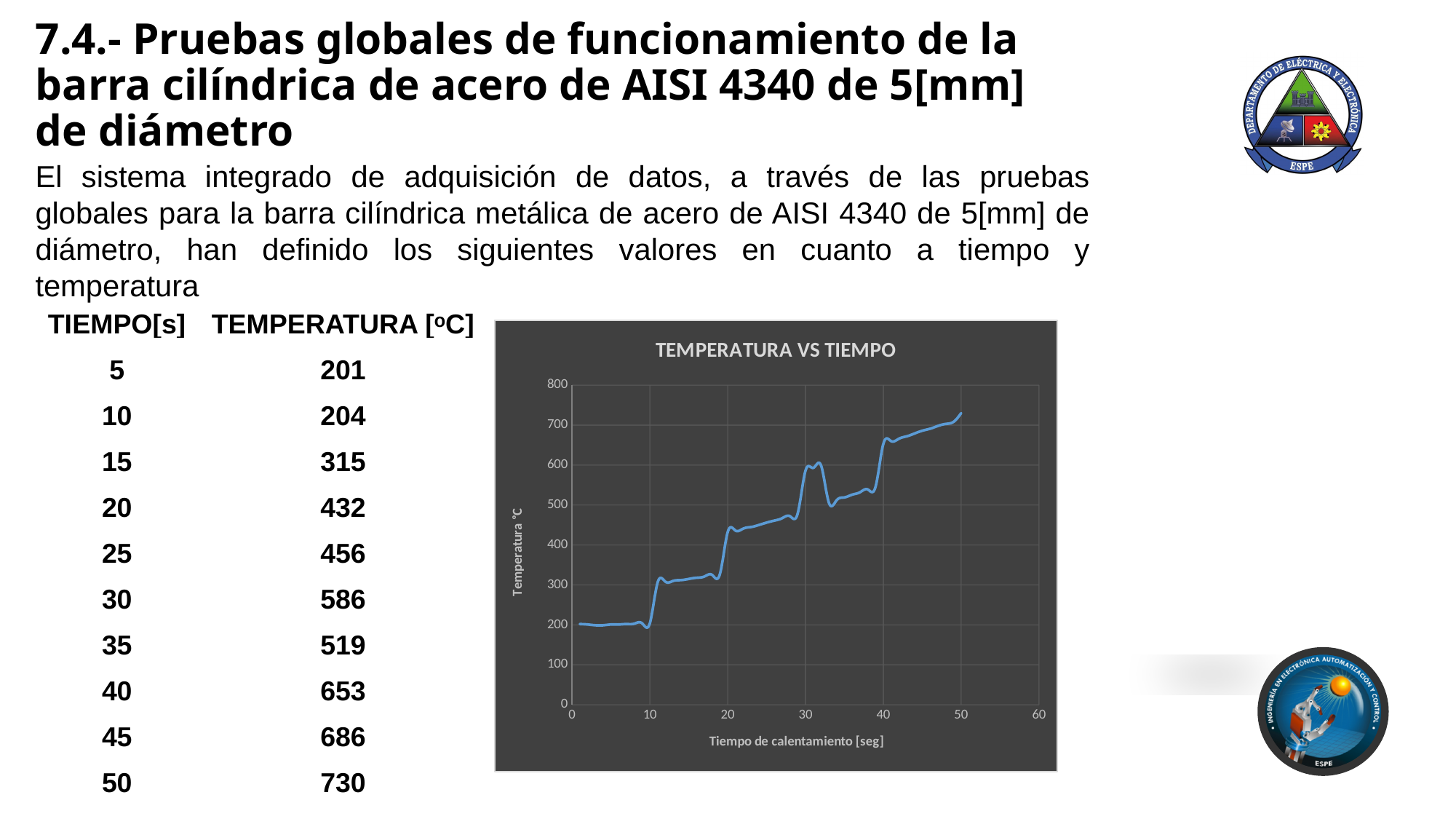
Is the temperature at 50 seconds greater or less than 700? greater What kind of chart is shown on the slide? line chart What is the label of the x axis of the chart? Tiempo de calentamiento [seg] According to the table next to the chart, what is the temperature at 5 seconds? 201 Is the temperature at 20 seconds greater or less than 400? greater Is the temperature at 10 seconds greater or less than 300? less Using the table values, what is the difference between the temperature at 50 seconds and at 5 seconds? 529 What is the title of the chart? TEMPERATURA VS TIEMPO At which time listed in the table is the temperature highest? 50 Overall, does the temperature rise or fall as the heating time increases along the x axis? rise According to the table next to the chart, what is the temperature at 50 seconds? 730